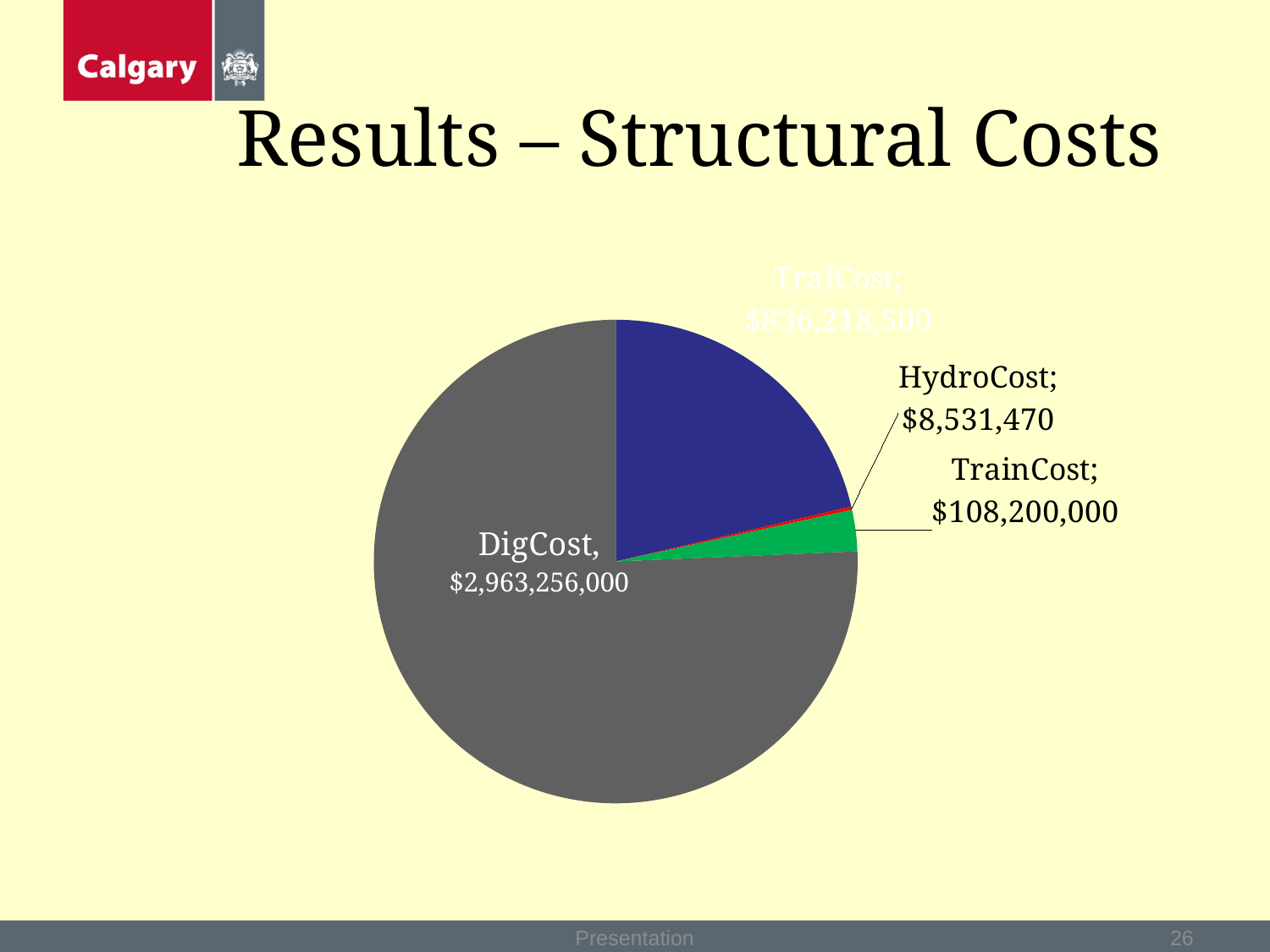
Which cost category has the largest slice of the pie chart? DigCost How much larger is TrainCost than HydroCost? $99,668,530 Which cost category has the smallest slice of the pie chart? HydroCost What is the title of the slide containing the pie chart? Results – Structural Costs What is the difference between DigCost and TrafCost? $2,127,037,500 How many slices does the pie chart have? 4 What kind of chart is shown on the slide? pie chart What is the value of HydroCost in the pie chart? $8,531,470 What is the value of TrainCost in the pie chart? $108,200,000 What is the value of DigCost in the pie chart? $2,963,256,000 What is the value of TrafCost in the pie chart? $836,218,500 Which is larger, TrainCost or HydroCost? TrainCost